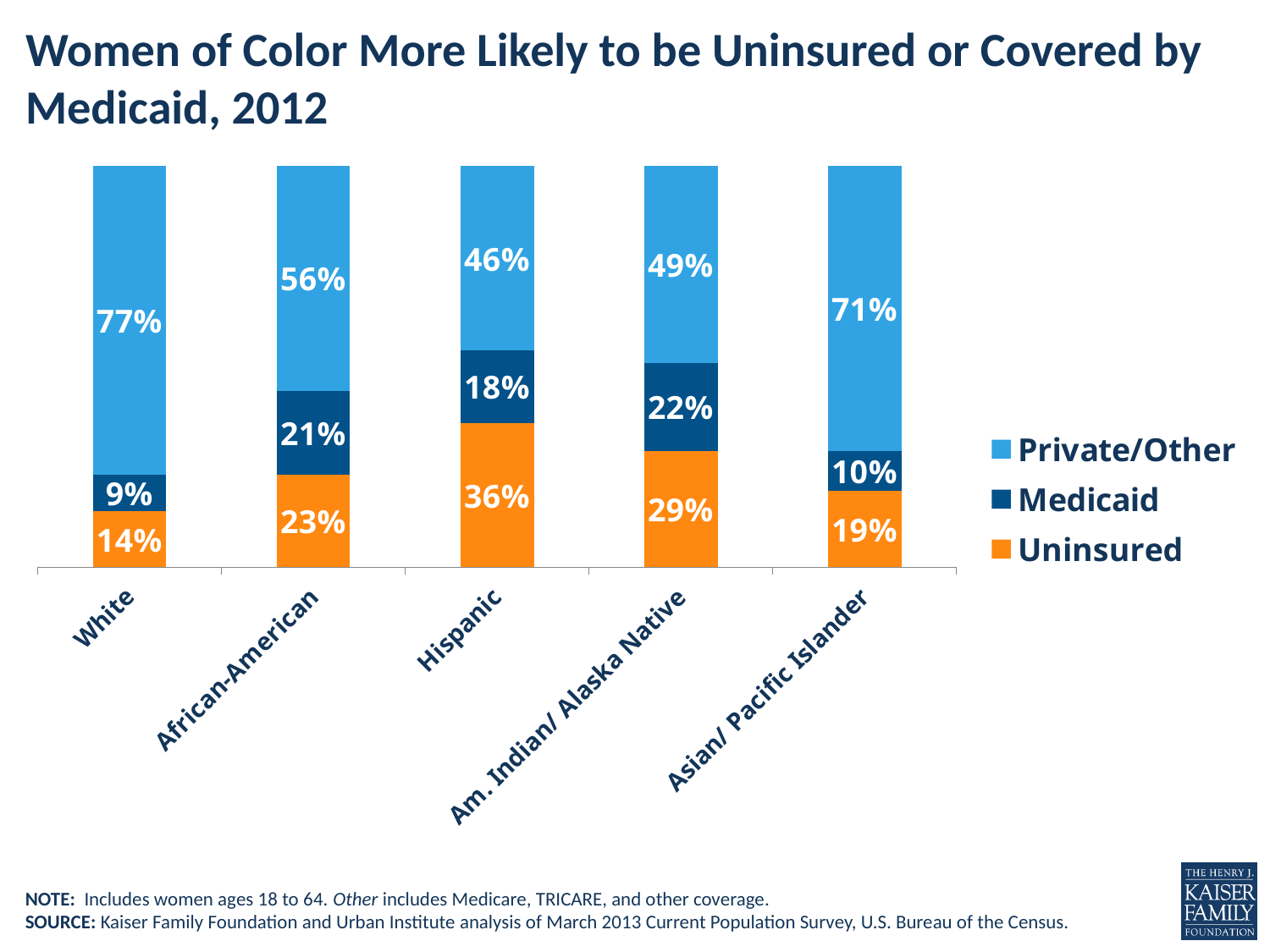
What is the Medicaid value for White women? 9% What is the Medicaid value for African-American women? 21% What is the difference between the Uninsured values for Am. Indian/Alaska Native and White women? 15% Which is larger, the Medicaid value for Am. Indian/Alaska Native women or for Asian/Pacific Islander women? Am. Indian/Alaska Native What kind of chart is shown on the slide? Stacked bar chart How many racial/ethnic groups are shown on the x axis? 5 What is the Private/Other value for Asian/Pacific Islander women? 71% Which group has the lowest Private/Other share? Hispanic Which legend entry is shown in orange? Uninsured How many series does the legend list? 3 Which group has the highest Uninsured share? Hispanic What is the Uninsured value for Hispanic women? 36%